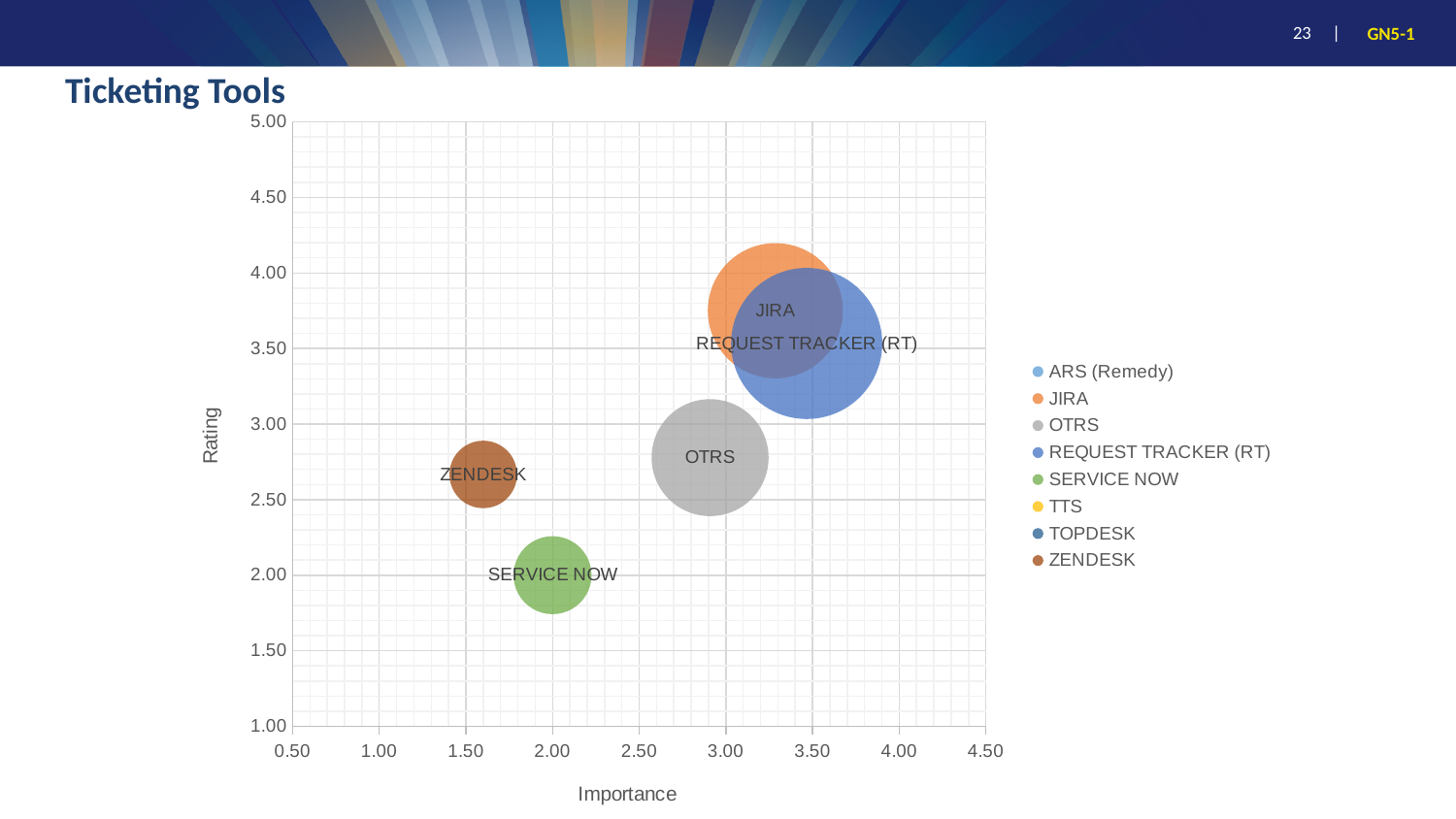
What is the label of the horizontal axis? Importance Which has the higher Rating, OTRS or SERVICE NOW? OTRS Which tool has the highest Rating? JIRA Which tool has the lowest Importance? ZENDESK Is the Importance for OTRS greater or less than 2.50? greater Is the Rating for SERVICE NOW greater or less than 2.50? less Is the Rating for JIRA greater or less than 3.50? greater How many bubbles are plotted on the chart? 5 How many series does the legend list? 8 What kind of chart is shown on the slide? bubble chart Which tool has the lowest Rating? SERVICE NOW